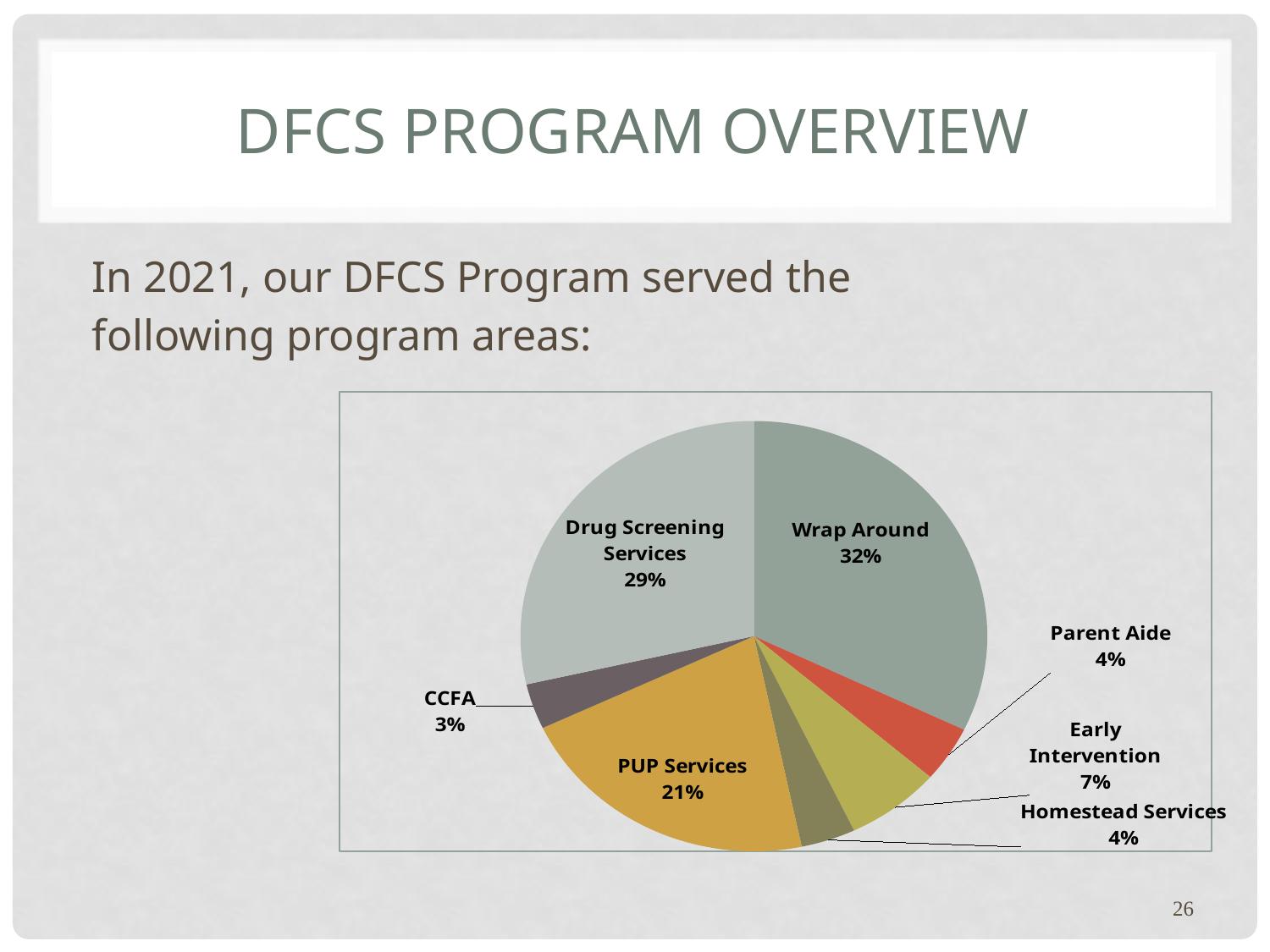
What percentage is shown for PUP Services? 21% What share of the pie does Wrap Around represent? 32% Which is larger, the share for Early Intervention or the share for Parent Aide? Early Intervention What percentage is shown for Drug Screening Services? 29% What percentage is shown for CCFA? 3% Which program area has the largest share of the pie? Wrap Around What is the difference in percentage points between Wrap Around and PUP Services? 11 How many program areas (slices) are shown in the pie chart? 7 Which program area has the smallest share of the pie? CCFA What kind of chart is shown on the slide? pie chart Which two program areas each have a share of 4%? Parent Aide and Homestead Services What percentage is shown for Early Intervention? 7%